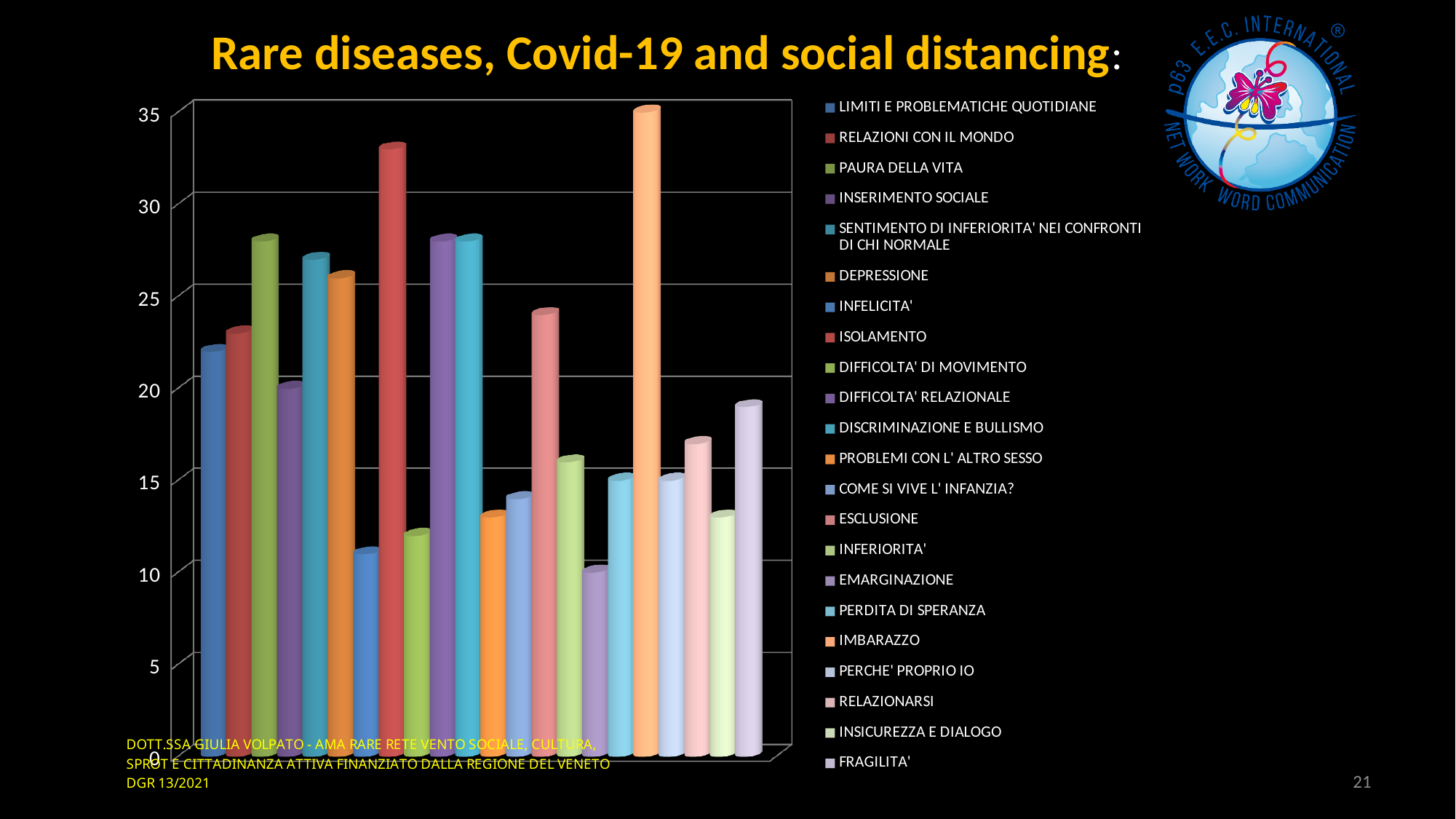
What is the title of the slide containing the chart? Rare diseases, Covid-19 and social distancing Is the value for EMARGINAZIONE greater or less than 15? less Is the value for PAURA DELLA VITA greater or less than 25? greater What kind of chart is shown on the slide? bar chart Is the value for INFELICITA' greater or less than 15? less Which is larger, the value for PAURA DELLA VITA or the value for INFELICITA'? PAURA DELLA VITA Which series has the highest bar in the chart? IMBARAZZO Which is larger, the value for ISOLAMENTO or the value for ESCLUSIONE? ISOLAMENTO How many series does the legend list? 22